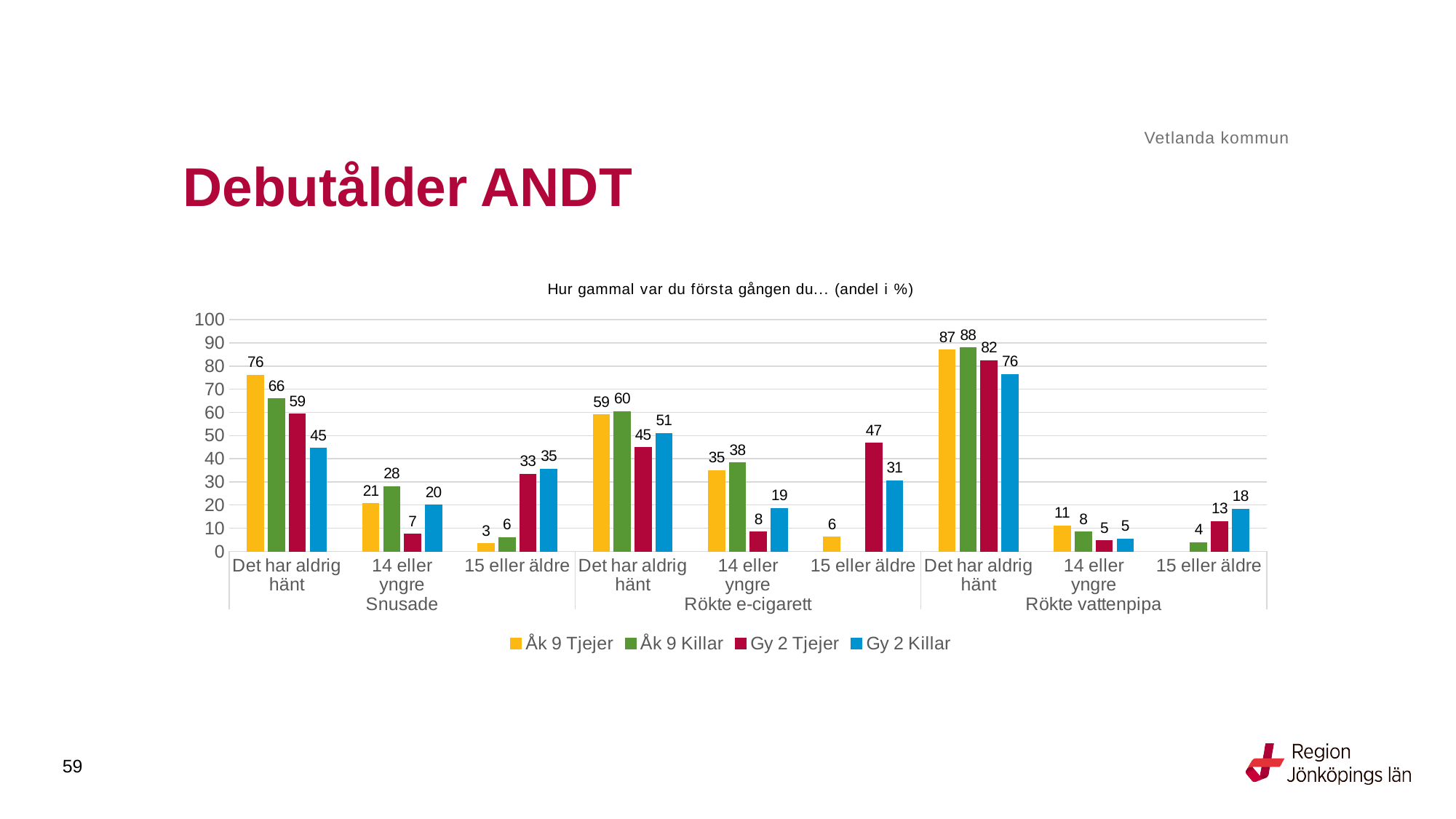
What is the value for Gy 2 Killar in the 'Det har aldrig hänt' category under Rökte vattenpipa? 76 Which colour represents Gy 2 Killar in the legend? Blue What is the difference between Åk 9 Tjejer and Gy 2 Killar in the 'Det har aldrig hänt' category under Snusade? 31 Which series has the lowest value in the '14 eller yngre' category under Snusade? Gy 2 Tjejer What is the value for Gy 2 Tjejer in the '15 eller äldre' category under Rökte e-cigarett? 47 How many category groups (Snusade, Rökte e-cigarett, Rökte vattenpipa) are shown on the x axis? 3 How many series does the legend list? 4 Which series has the highest value in the 'Det har aldrig hänt' category under Rökte vattenpipa? Åk 9 Killar What is the title of the chart? Hur gammal var du första gången du… (andel i %) What is the value for Åk 9 Tjejer in the 'Det har aldrig hänt' category under Snusade? 76 Which is larger in the '14 eller yngre' category under Rökte e-cigarett: Åk 9 Killar or Gy 2 Killar? Åk 9 Killar What kind of chart is shown on the slide? Bar chart